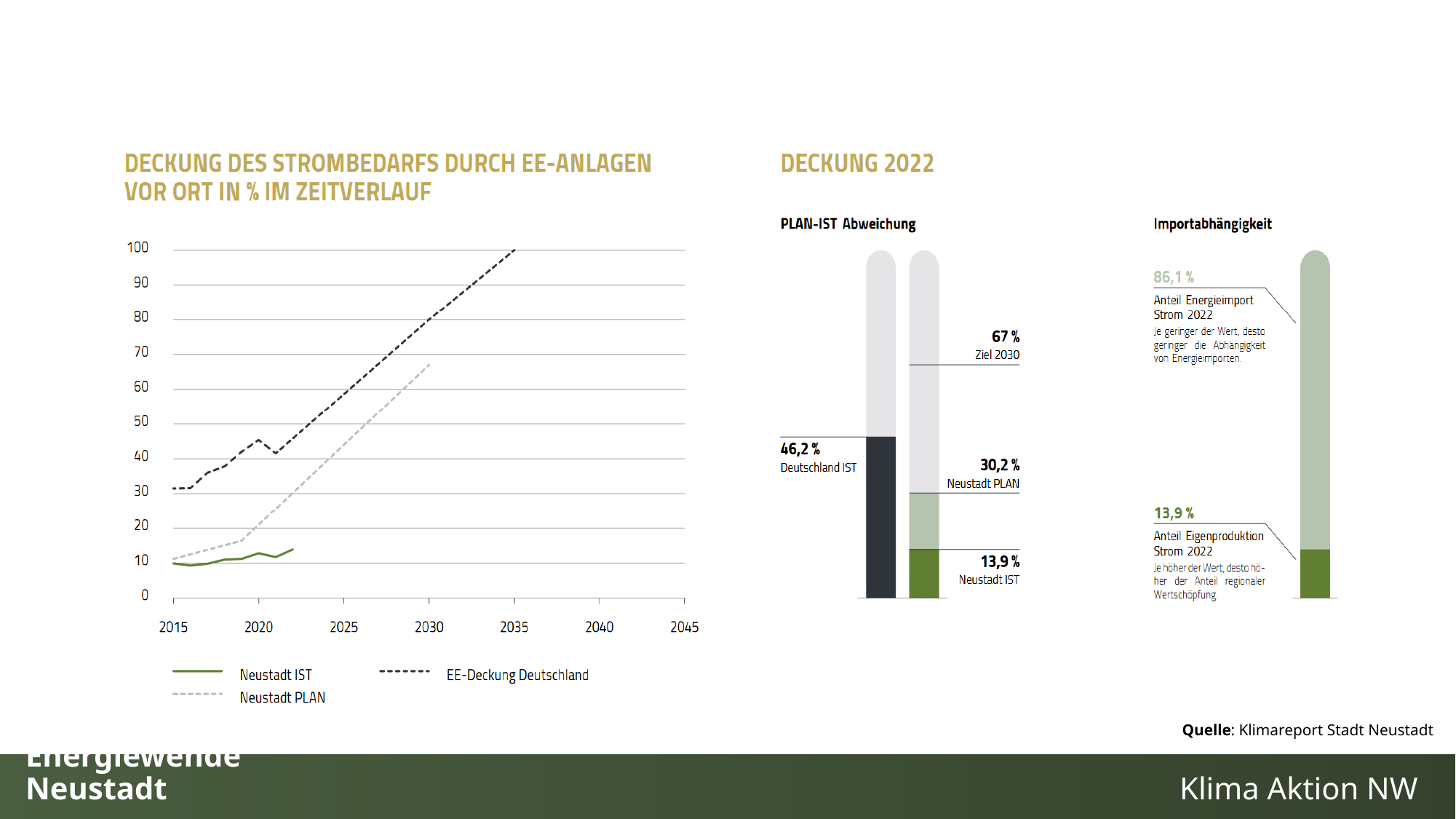
In the 'Deckung 2022' chart, what is the value for Deutschland IST in the PLAN-IST Abweichung bars? 46,2 % What kind of chart is the chart titled 'Deckung des Strombedarfs durch EE-Anlagen vor Ort in % im Zeitverlauf'? line chart In the chart 'Deckung des Strombedarfs durch EE-Anlagen vor Ort in % im Zeitverlauf', is the value for EE-Deckung Deutschland in 2015 greater or less than 20? greater In the 'Deckung 2022' chart, what is the difference between Deutschland IST and Neustadt IST? 32,3 % In the Importabhängigkeit bar of the 'Deckung 2022' chart, what is the value for Anteil Energieimport Strom 2022? 86,1 % In the chart 'Deckung des Strombedarfs durch EE-Anlagen vor Ort in % im Zeitverlauf', does the Neustadt PLAN line rise or fall from 2015 to 2030? rise In the chart 'Deckung des Strombedarfs durch EE-Anlagen vor Ort in % im Zeitverlauf', is the value for Neustadt IST in 2020 greater or less than 20? less In the 'Deckung 2022' chart, which of the labelled values in the PLAN-IST Abweichung bars is the highest? Ziel 2030 (67 %) In the 'Deckung 2022' chart, what is the difference between Neustadt PLAN and Neustadt IST? 16,3 % In the 'Deckung 2022' chart, what is the value for Neustadt PLAN? 30,2 % In the chart 'Deckung des Strombedarfs durch EE-Anlagen vor Ort in % im Zeitverlauf', which series is higher in 2020, Neustadt IST or EE-Deckung Deutschland? EE-Deckung Deutschland How many series does the legend of the chart 'Deckung des Strombedarfs durch EE-Anlagen vor Ort in % im Zeitverlauf' list? 3